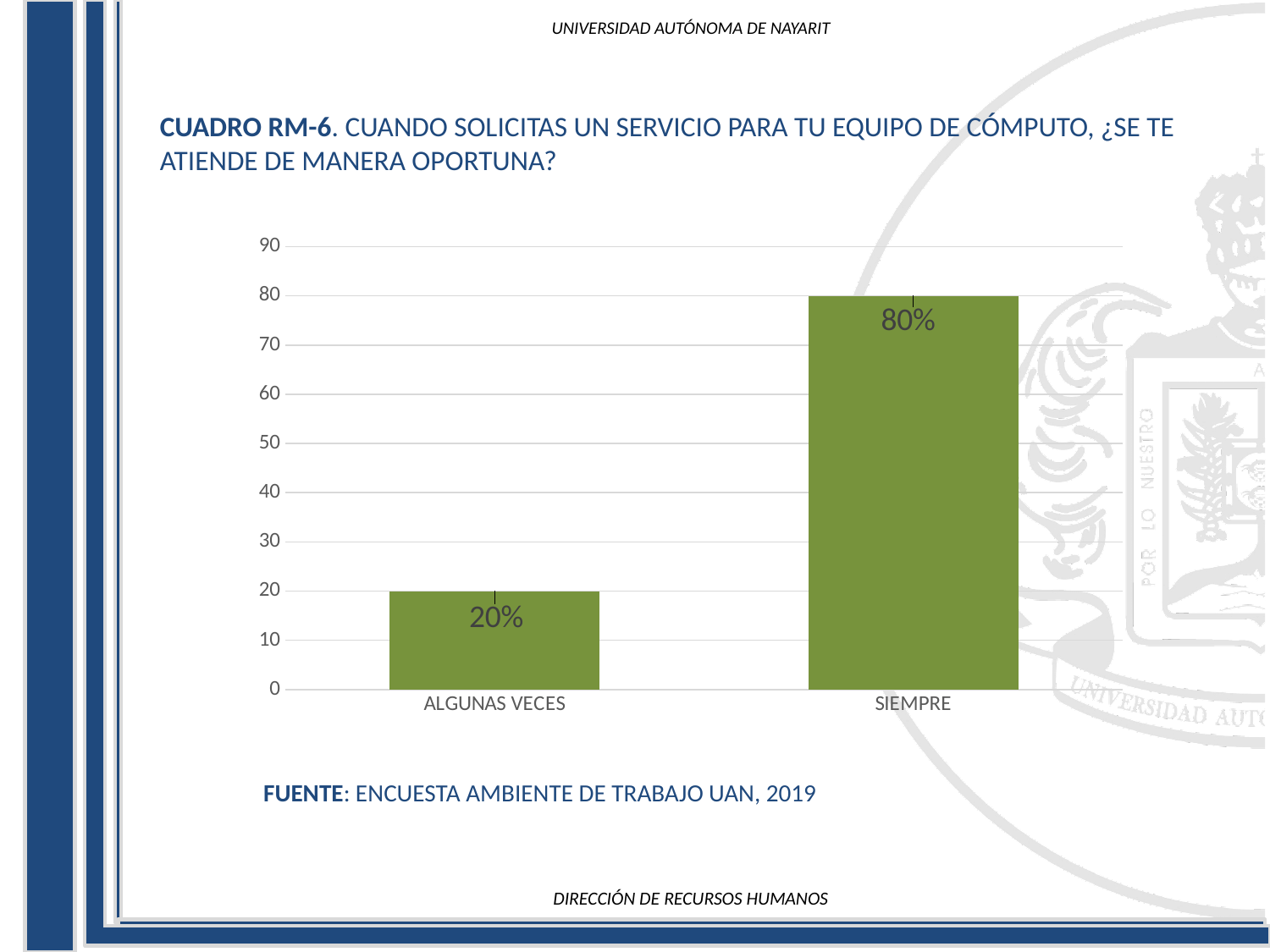
What kind of chart is shown on the slide? bar chart What is the highest value shown on the vertical axis? 90 Which is larger, the value for ALGUNAS VECES or the value for SIEMPRE? SIEMPRE Is the value for SIEMPRE greater or less than 50? greater Which category has the highest value? SIEMPRE Which category has the lowest value? ALGUNAS VECES What is the difference between the values for SIEMPRE and ALGUNAS VECES? 60% What is the value for SIEMPRE? 80% How many categories are shown on the x axis? 2 Is the value for ALGUNAS VECES greater or less than 30? less What source is cited below the chart? ENCUESTA AMBIENTE DE TRABAJO UAN, 2019 What is the value for ALGUNAS VECES? 20%